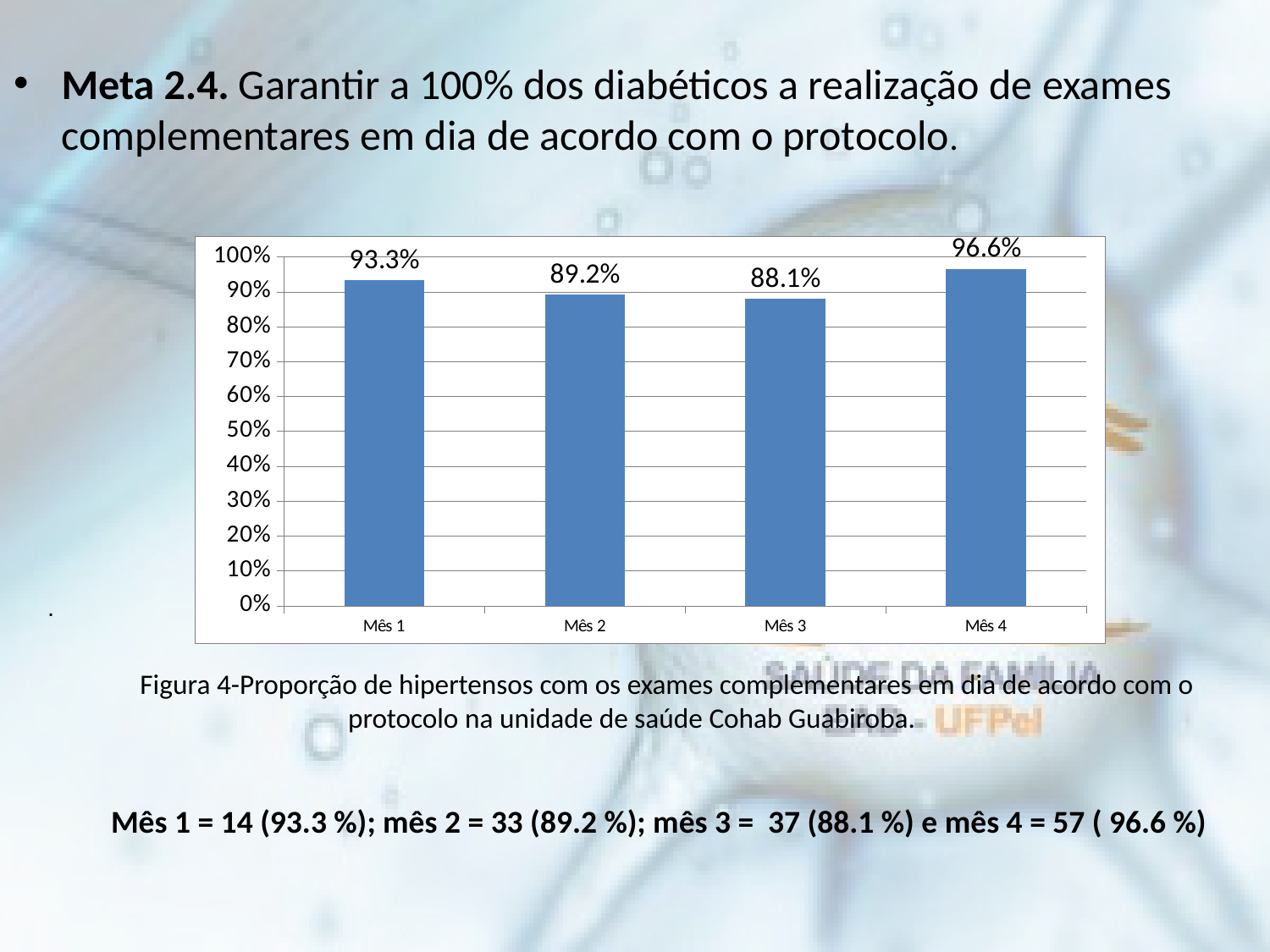
What kind of chart is shown on the slide? bar chart What is the difference between the values for Mês 2 and Mês 3? 1.1% Is the value for Mês 3 greater or less than 90%? less What is the highest value shown on the y axis? 100% What is the value for Mês 4? 96.6% What is the value for Mês 3? 88.1% Which month has the lowest value? Mês 3 Which is larger, the value for Mês 1 or the value for Mês 2? Mês 1 What is the difference between the values for Mês 4 and Mês 1? 3.3% What is the value for Mês 1? 93.3% Which month has the highest value? Mês 4 How many months are shown on the x axis? 4